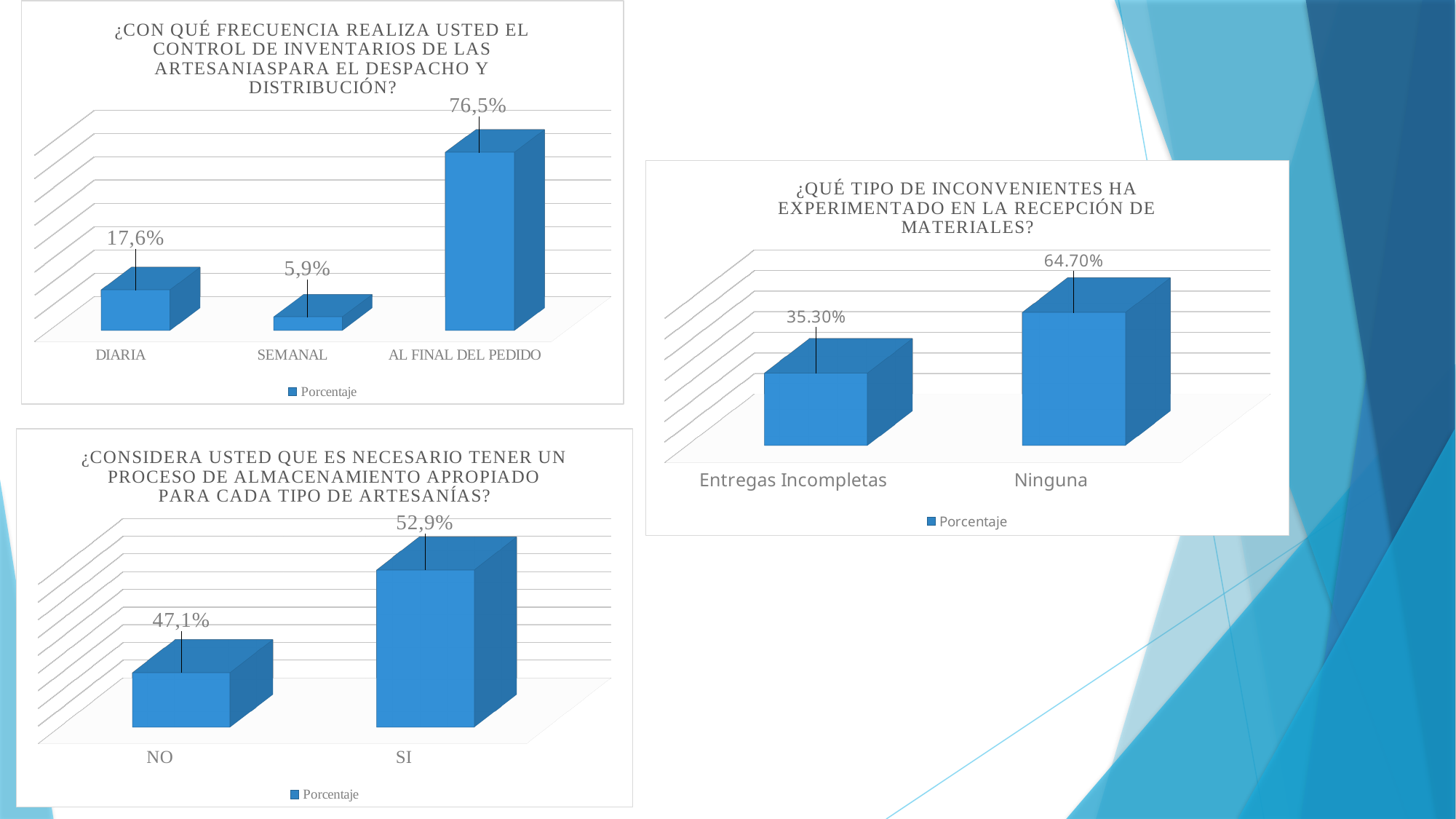
In the bottom-left chart about the need for an appropriate storage process, what is the difference between SI and NO? 5,8% In the top-left chart about the frequency of inventory control, how many categories are shown? 3 What type of chart is the right-hand chart about inconveniences in receiving materials? Bar chart In the top-left chart about the frequency of inventory control, what is the difference between AL FINAL DEL PEDIDO and DIARIA? 58,9% In the top-left chart about the frequency of inventory control, what is the value for AL FINAL DEL PEDIDO? 76,5% In the top-left chart about the frequency of inventory control, which category has the lowest value? SEMANAL In the top-left chart about the frequency of inventory control, what is the value for SEMANAL? 5,9% In the right-hand chart about inconveniences in receiving materials, which category has the highest value? Ninguna In the bottom-left chart about the need for an appropriate storage process, what is the value for NO? 47,1% In the right-hand chart about inconveniences in receiving materials, what is the value for Entregas Incompletas? 35.30% In the right-hand chart about inconveniences in receiving materials, what is the difference between Ninguna and Entregas Incompletas? 29.40% In the bottom-left chart about the need for an appropriate storage process, which is larger, SI or NO? SI